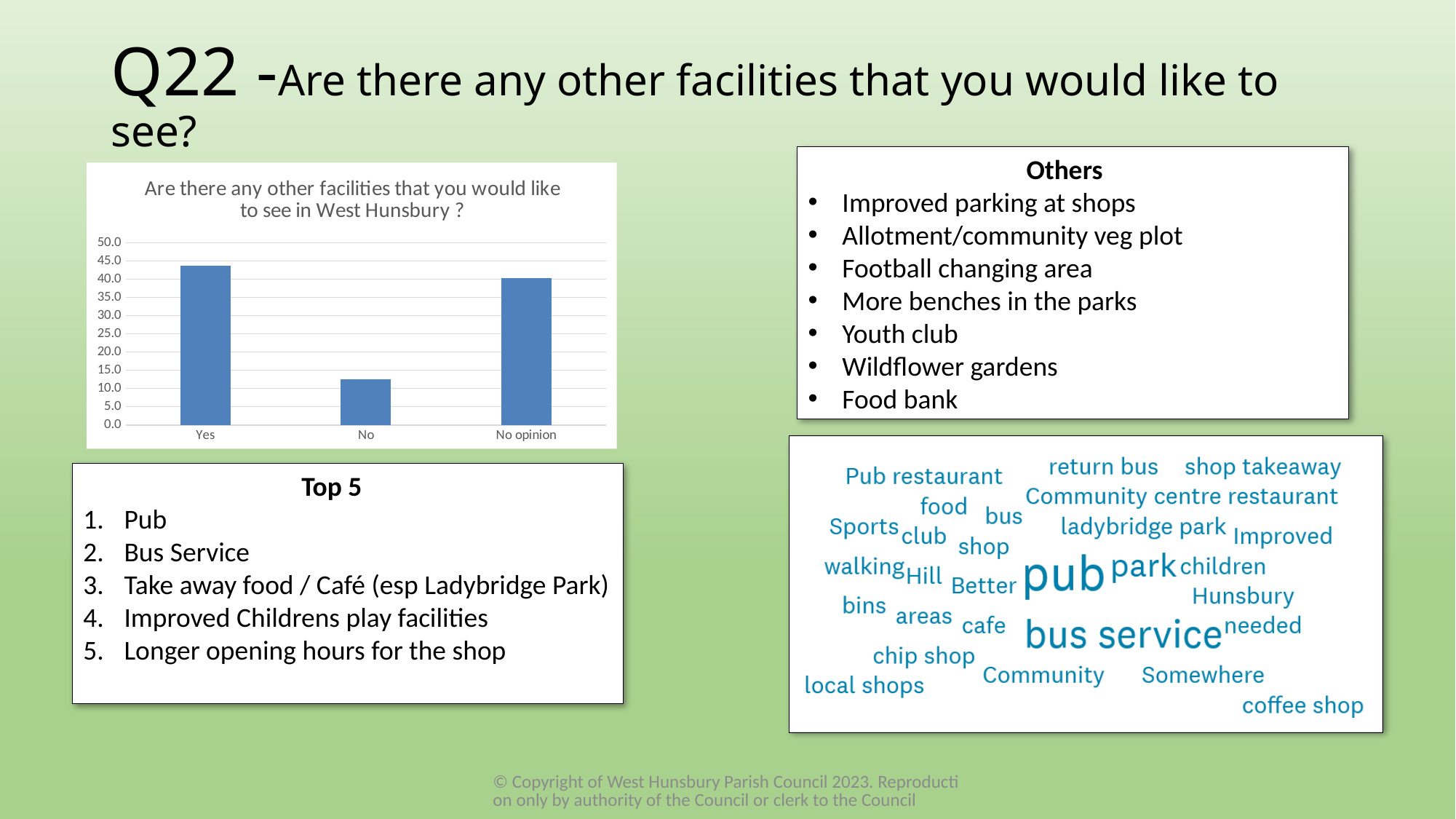
Is the value for No greater or less than 15.0? less Is the value for Yes greater or less than 40.0? greater What is the highest value shown on the chart's y axis? 50.0 What is the title of the chart? Are there any other facilities that you would like to see in West Hunsbury ? Which category has the lowest value in the chart? No Which is larger, the value for No or the value for No opinion? No opinion Is the value for No opinion greater or less than 45.0? less What kind of chart is shown on the slide? bar chart How many categories are shown on the x axis of the chart? 3 Which category has the highest value in the chart? Yes